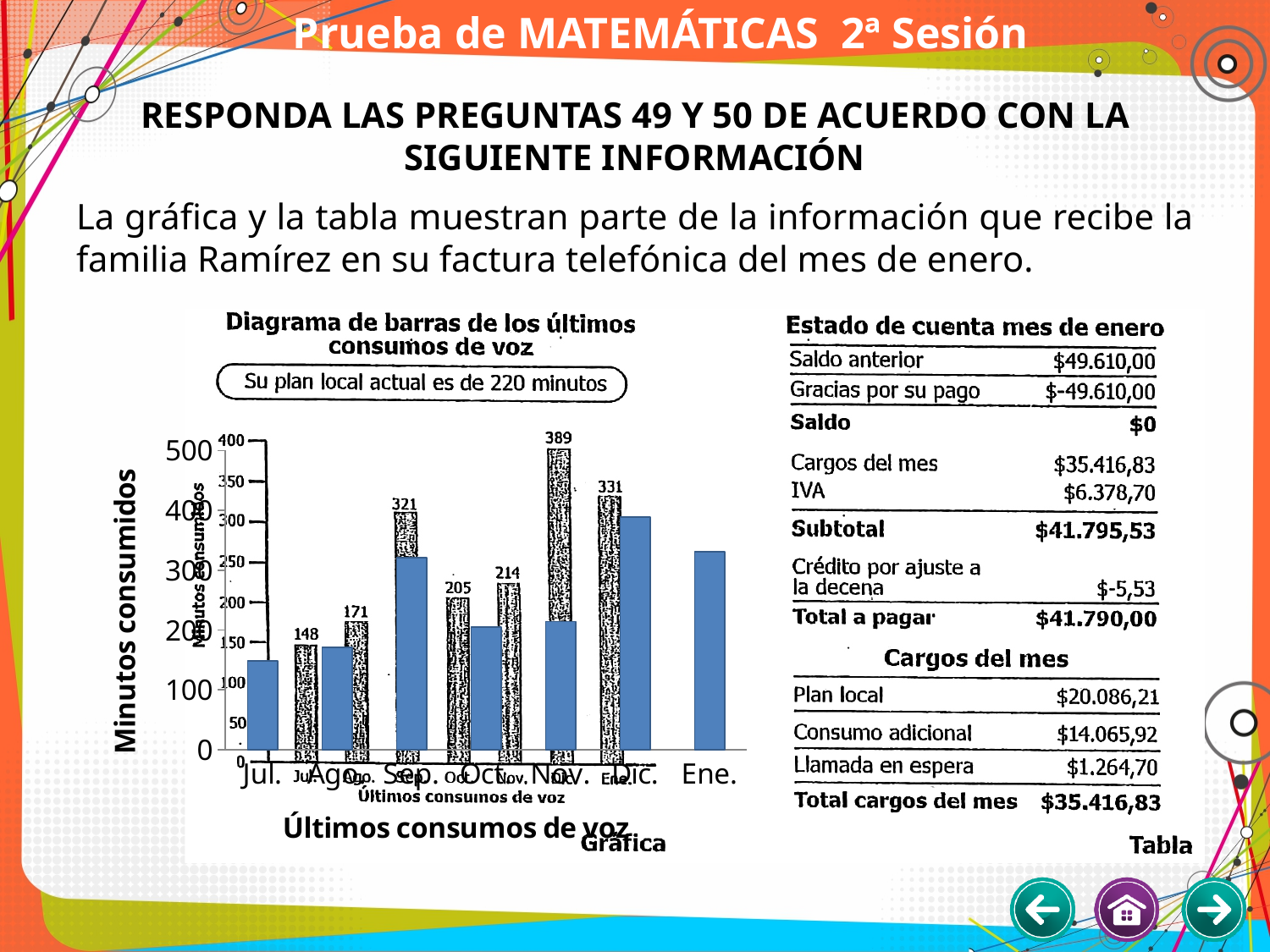
Which month has the highest value in the bar chart? Dic. Which month has the lowest value in the bar chart? Jul. What is the difference between the labelled values for Dic. and Jul.? 241 How many months (categories) are shown on the x axis of the bar chart? 7 What value is labelled for Jul. in the bar chart? 148 According to the note on the chart, how many minutes is the current local plan? 220 minutos What value is labelled for Ene. in the bar chart? 331 Which is larger, the value for Oct. or the value for Nov.? Nov. What value is labelled for Sep. in the bar chart? 321 What is the title of the bar chart? Diagrama de barras de los últimos consumos de voz What value is labelled for Dic. in the bar chart? 389 What kind of chart is shown on the slide? bar chart